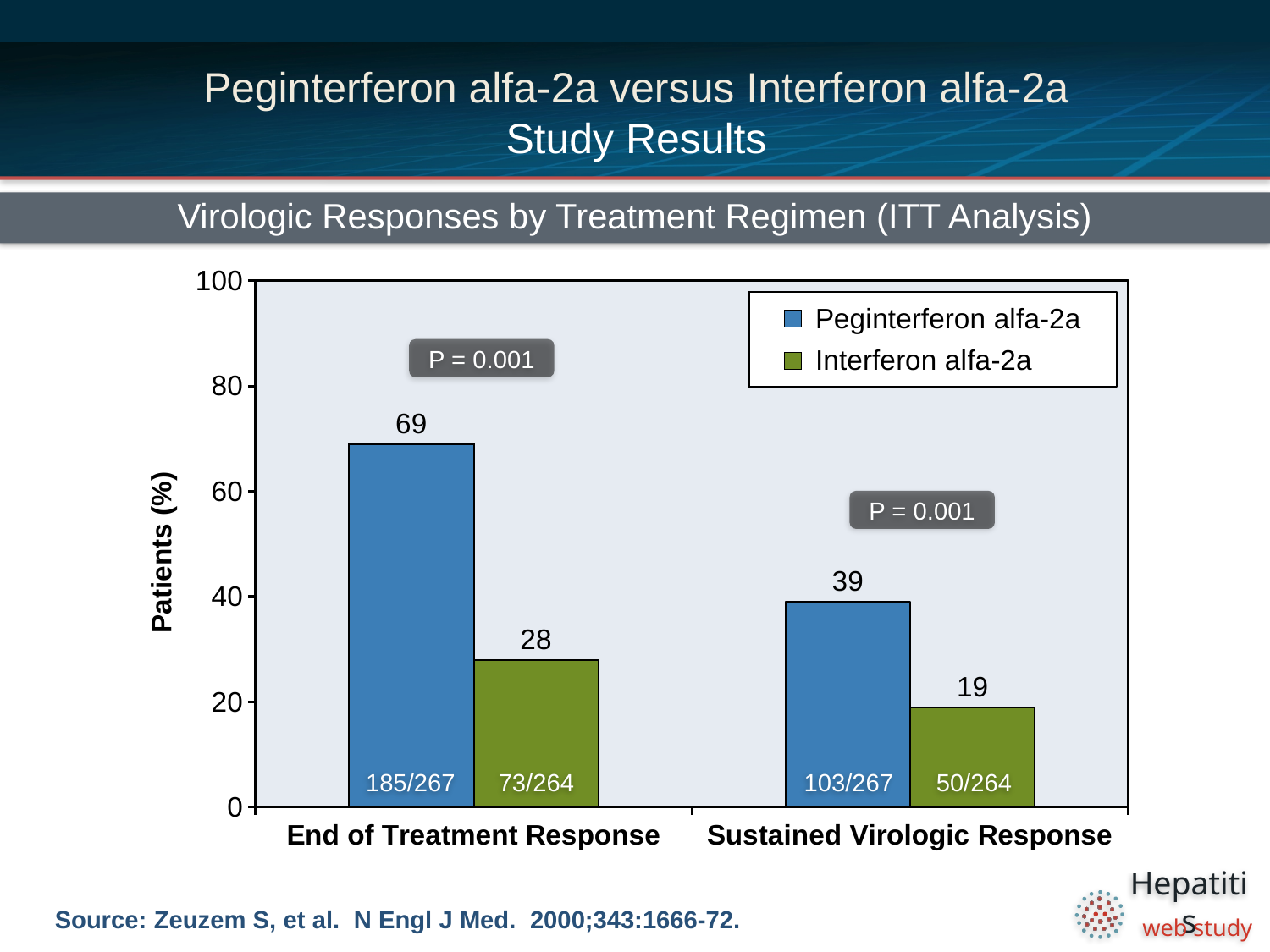
What is the value for Interferon alfa-2a in the End of Treatment Response category? 28 What is the value for Peginterferon alfa-2a in the End of Treatment Response category? 69 What is the difference between Peginterferon alfa-2a and Interferon alfa-2a in the Sustained Virologic Response category? 20 Which bar on the chart has the lowest value? Interferon alfa-2a, Sustained Virologic Response Which is larger: Peginterferon alfa-2a for Sustained Virologic Response or Interferon alfa-2a for End of Treatment Response? Peginterferon alfa-2a for Sustained Virologic Response What is the difference between Peginterferon alfa-2a and Interferon alfa-2a in the End of Treatment Response category? 41 Which series has the highest value in the End of Treatment Response category? Peginterferon alfa-2a What is the label of the y axis? Patients (%) What is the value for Interferon alfa-2a in the Sustained Virologic Response category? 19 How many categories are shown on the x axis? 2 What kind of chart is shown on the slide? Bar chart How many series does the legend list? 2